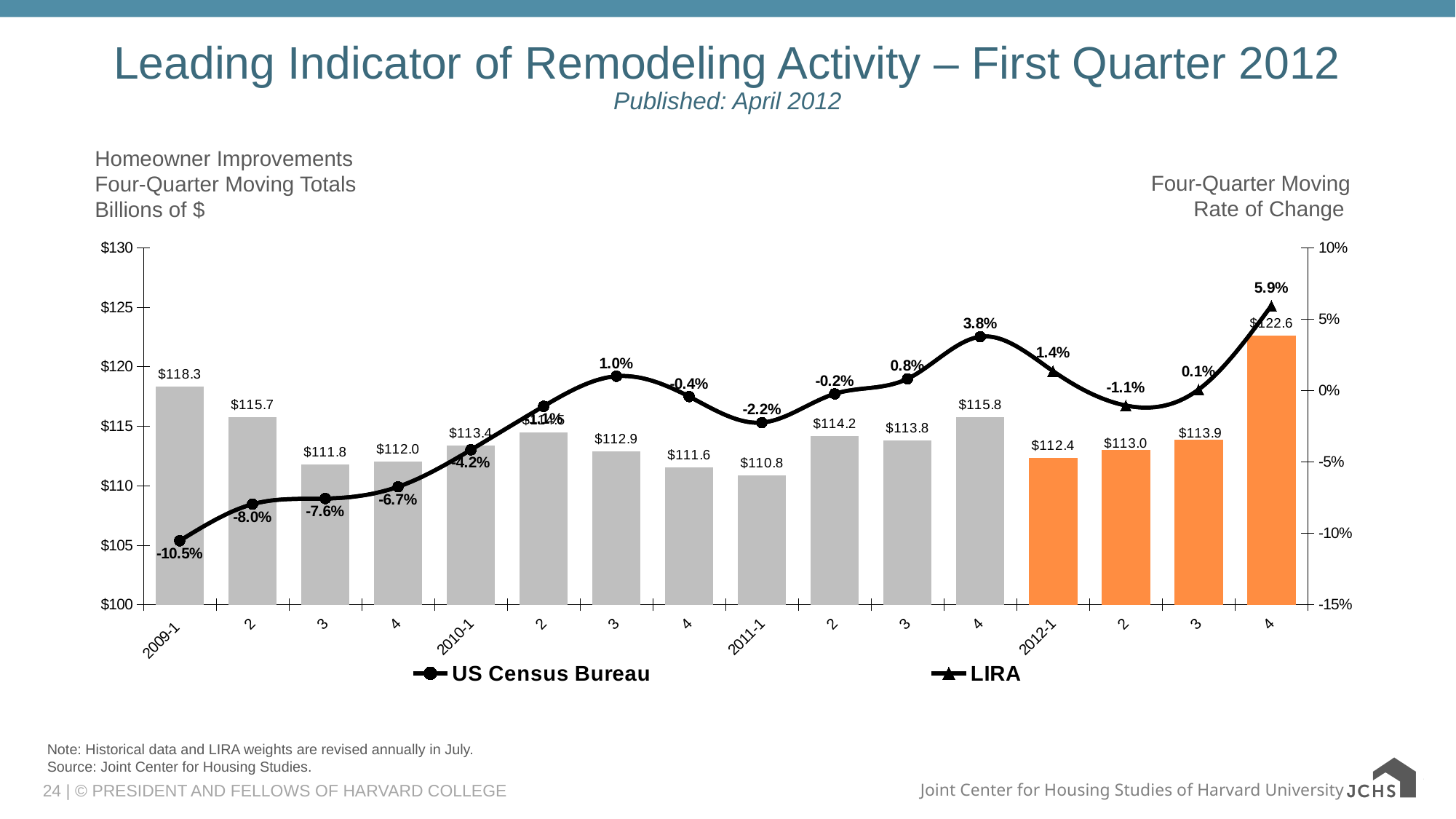
Which quarter has the highest four-quarter moving total bar? 2012-4 ($122.6) How many quarterly bars are plotted on the chart? 16 What kind of chart is this? Combined bar and line chart What is the four-quarter moving rate of change shown for 2011-4? 3.8% What is the rate of change shown for 2012-1? 1.4% Which quarters are shown with orange bars? 2012-1 through 2012-4 Which quarter has the lowest four-quarter moving total bar? 2011-1 ($110.8) Does the rate of change line rise or fall from 2009-1 to 2010-3? Rises How many series does the legend list? 2 Which is larger, the four-quarter moving total for 2009-2 or for 2011-2? 2009-2 ($115.7) What is the difference between the four-quarter moving totals for 2011-4 and 2011-3? $2.0 What is the four-quarter moving total of homeowner improvements for 2009-1? $118.3